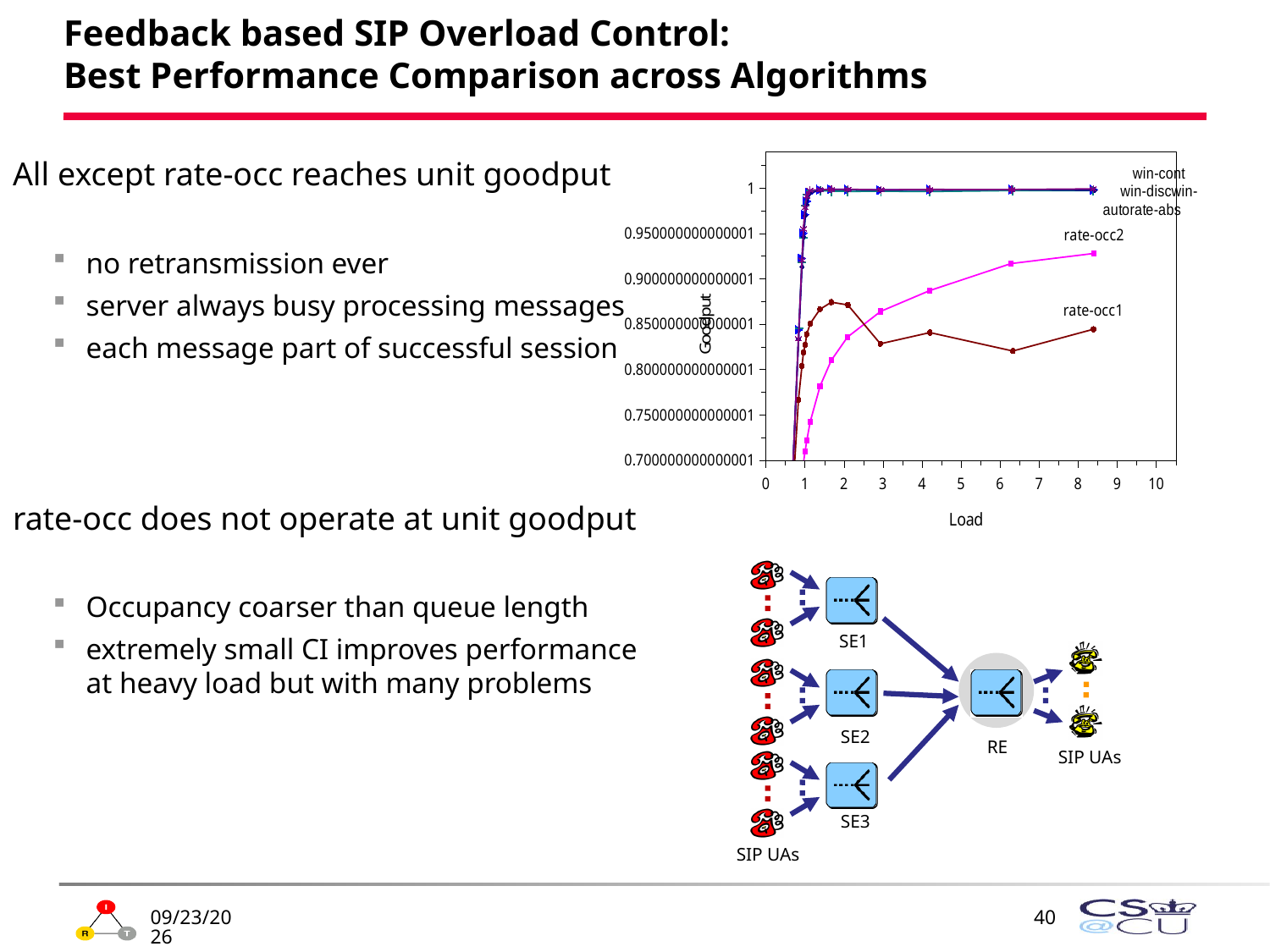
At a load of about 8, which series has the higher goodput, rate-occ1 or rate-occ2? rate-occ2 What is the label of the x axis of the chart? Load Does the goodput of the rate-occ2 series rise or fall as load increases from 1 to 8? rise Which series has the lowest goodput at a load of about 6? rate-occ1 Is the goodput of rate-occ1 at a load of about 6 greater or less than 0.85? less What is the highest value labeled on the y axis of the chart? 1 Is the goodput of rate-occ2 at a load of about 8 greater or less than 0.9? greater What is the label of the y axis of the chart? Goodput Is the goodput of rate-occ2 at a load of about 4 greater or less than 0.85? greater What kind of chart is shown on the slide? line chart What is the largest load value labeled on the x axis of the chart? 10